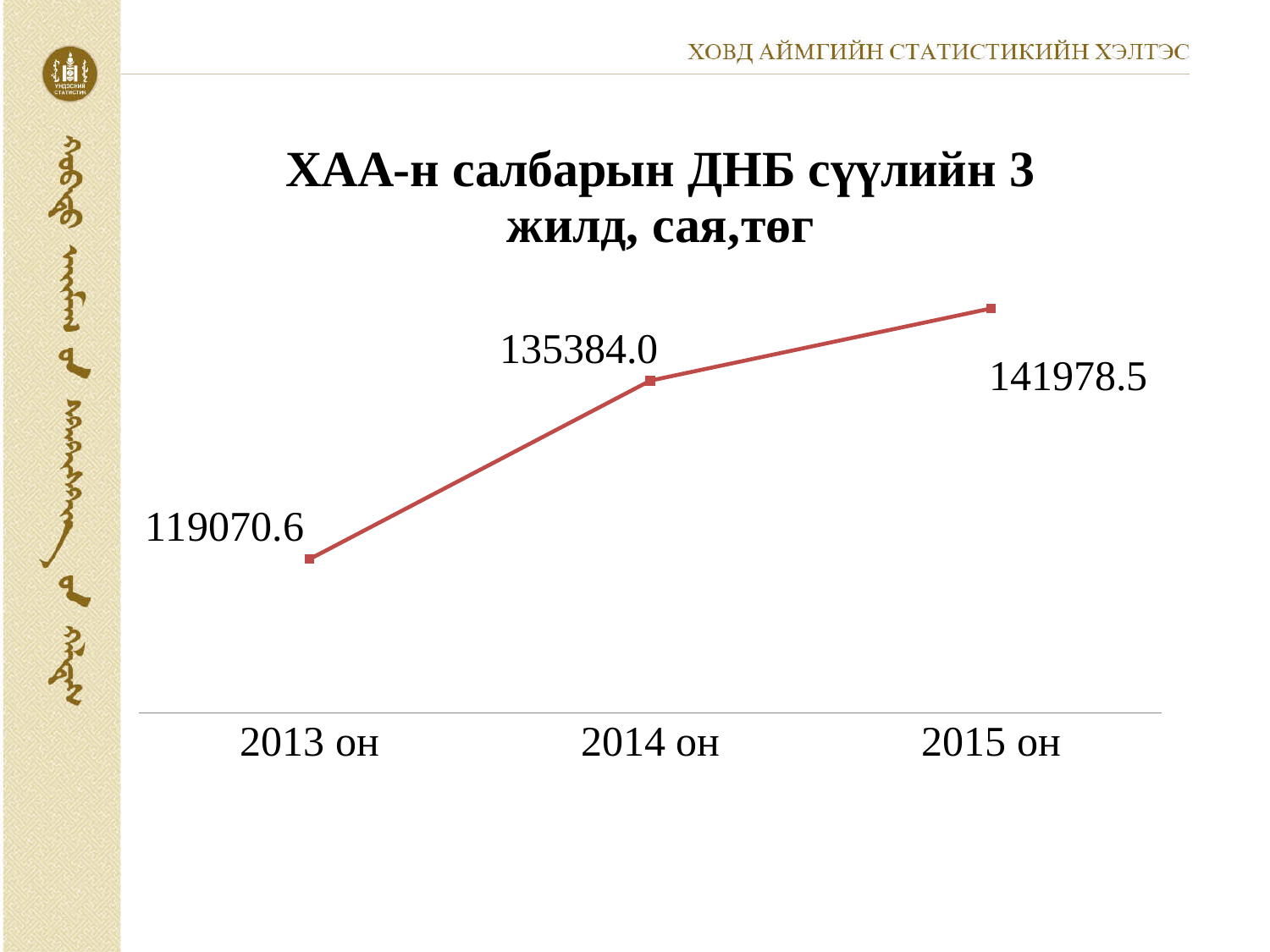
Which year has the lowest value? 2013 он What kind of chart is shown on the slide? Line chart What is the value for 2015 он? 141978.5 What is the difference between the values for 2014 он and 2013 он? 16313.4 What is the difference between the values for 2015 он and 2014 он? 6594.5 Do the values rise or fall from 2013 он to 2015 он? Rise What is the difference between the values for 2015 он and 2013 он? 22907.9 What is the value for 2014 он? 135384.0 How many data points are plotted on the chart? 3 Which year has the highest value? 2015 он Which is larger, the value for 2014 он or the value for 2015 он? 2015 он What is the value for 2013 он? 119070.6